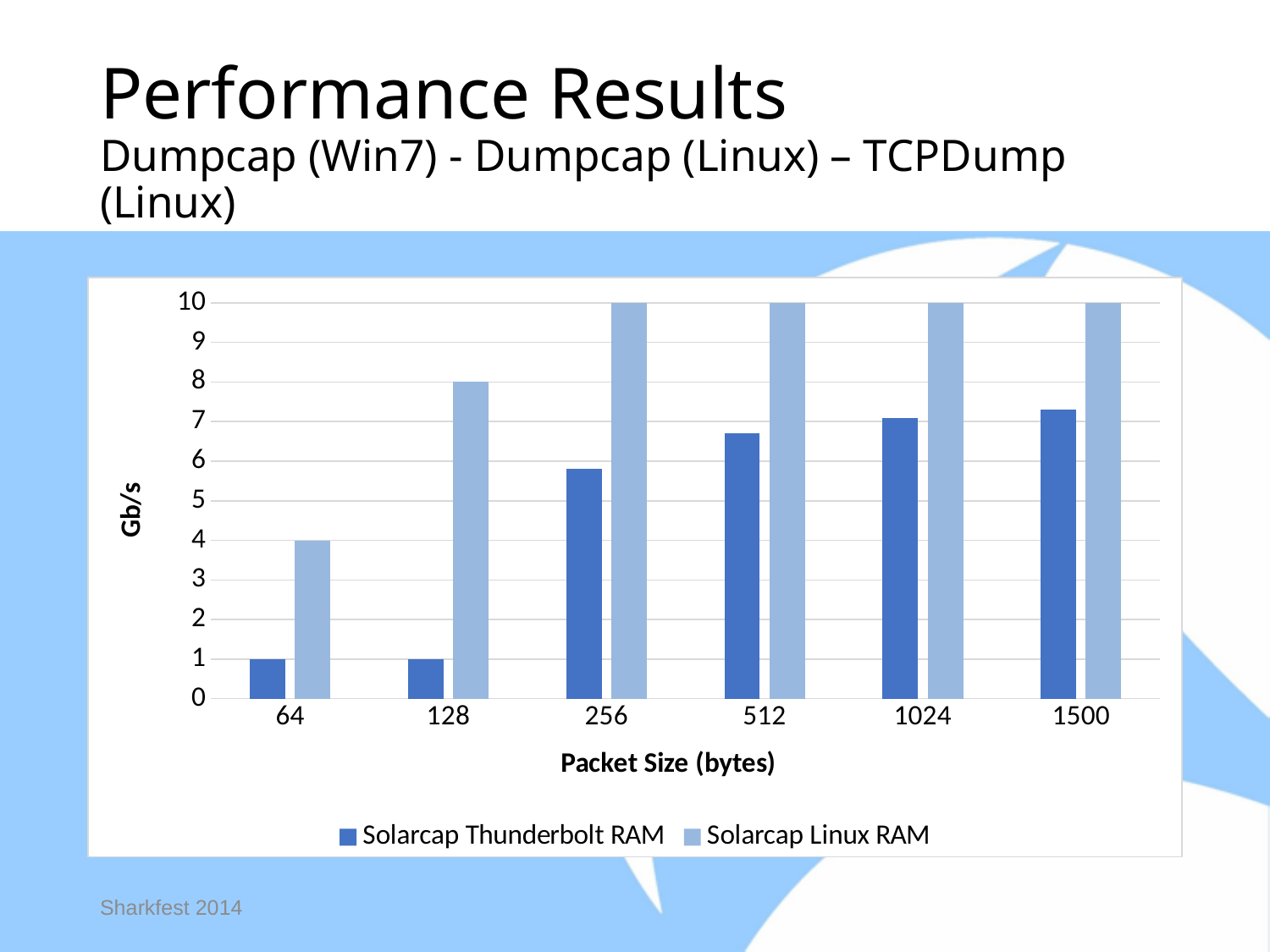
What is the difference between Solarcap Linux RAM and Solarcap Thunderbolt RAM at packet size 64? 3 At packet size 128, which series has the larger value, Solarcap Thunderbolt RAM or Solarcap Linux RAM? Solarcap Linux RAM What type of chart is shown on the slide? bar chart At which packet size is the Solarcap Linux RAM value lowest? 64 How many packet size categories are shown on the x axis? 6 Is the value for Solarcap Thunderbolt RAM at packet size 512 greater or less than 6? greater What is the value for Solarcap Linux RAM at packet size 1500? 10 What is the label on the y axis? Gb/s What is the value for Solarcap Linux RAM at packet size 128? 8 What is the value for Solarcap Thunderbolt RAM at packet size 64? 1 What is the value for Solarcap Linux RAM at packet size 64? 4 How many series does the legend list? 2